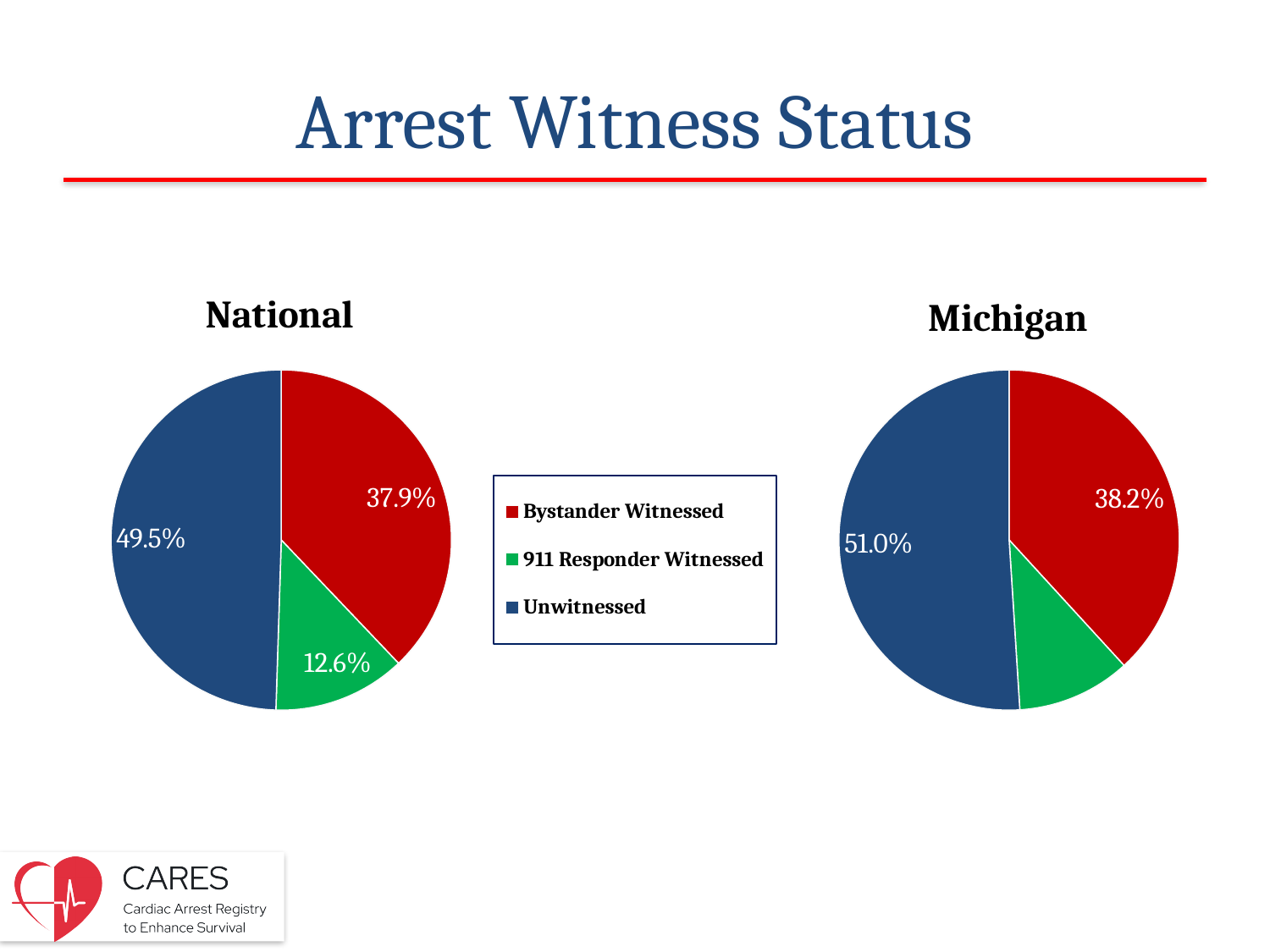
In the Michigan pie chart, what percentage is Unwitnessed? 51.0% In the National pie chart, what percentage is Unwitnessed? 49.5% In the National pie chart, what percentage is 911 Responder Witnessed? 12.6% What type of chart is used for the National data? Pie chart In the Michigan pie chart, which is larger: Unwitnessed or Bystander Witnessed? Unwitnessed In the National pie chart, which category has the largest share? Unwitnessed In the Michigan pie chart, what percentage is Bystander Witnessed? 38.2% In the Michigan pie chart, which category has the smallest share? 911 Responder Witnessed In the National pie chart, what is the difference in percentage points between Unwitnessed and Bystander Witnessed? 11.6 How many categories does the legend list for the pie charts? 3 In the National pie chart, what percentage is Bystander Witnessed? 37.9% Which colour represents 911 Responder Witnessed in the pie charts? Green